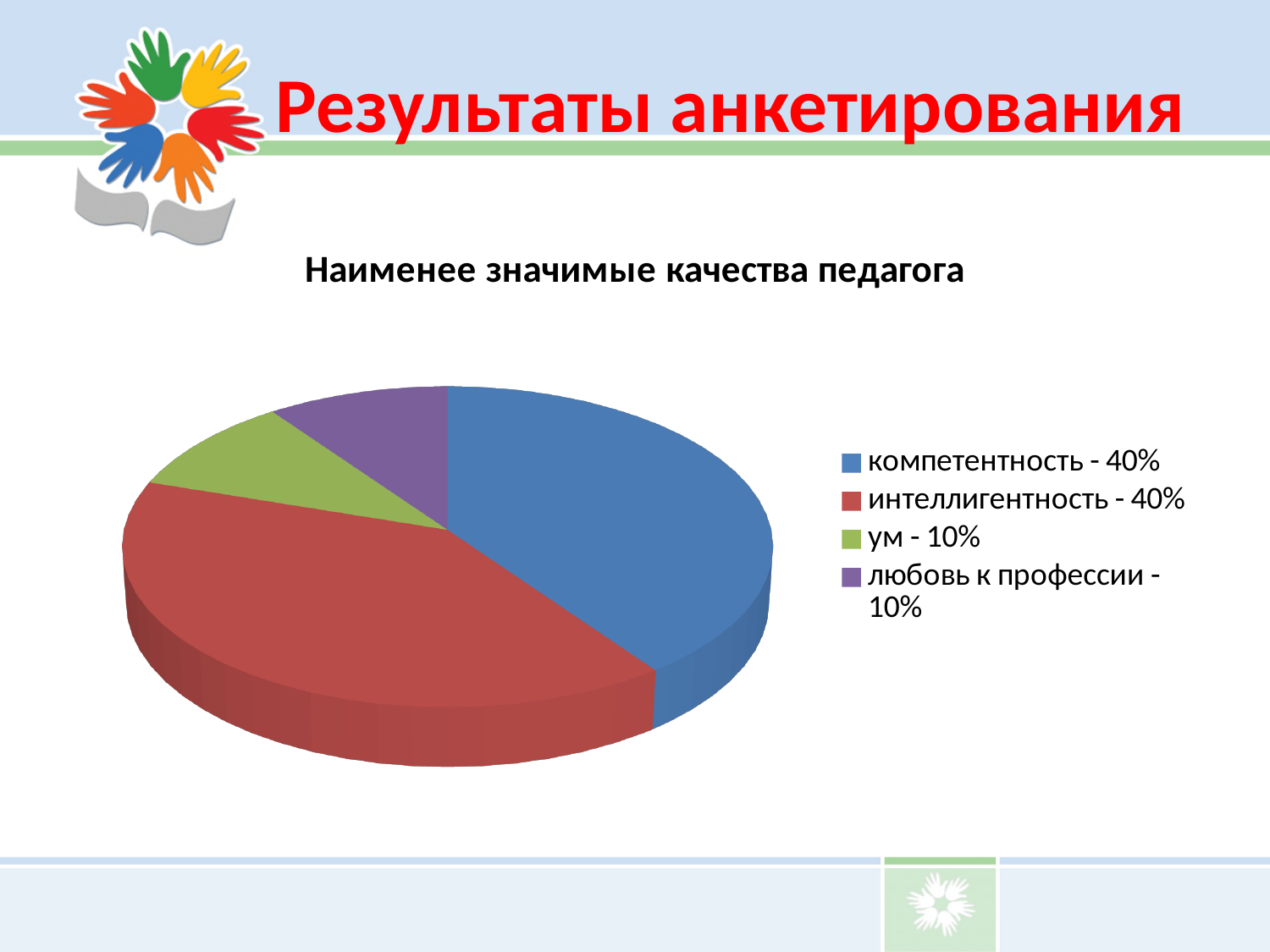
What is the value for любовь к профессии? 10% What is the difference between the values for компетентность and интеллигентность? 0% Which is larger, компетентность or ум? компетентность What is the title of the chart? Наименее значимые качества педагога What share of the pie does компетентность have? 40% What share of the pie does интеллигентность have? 40% Which colour represents ум in the pie chart? green Which is larger, любовь к профессии or интеллигентность? интеллигентность What kind of chart is shown on the slide? pie chart How many categories does the pie chart have? 4 What is the difference between the values for интеллигентность and любовь к профессии? 30% What is the value for ум? 10%